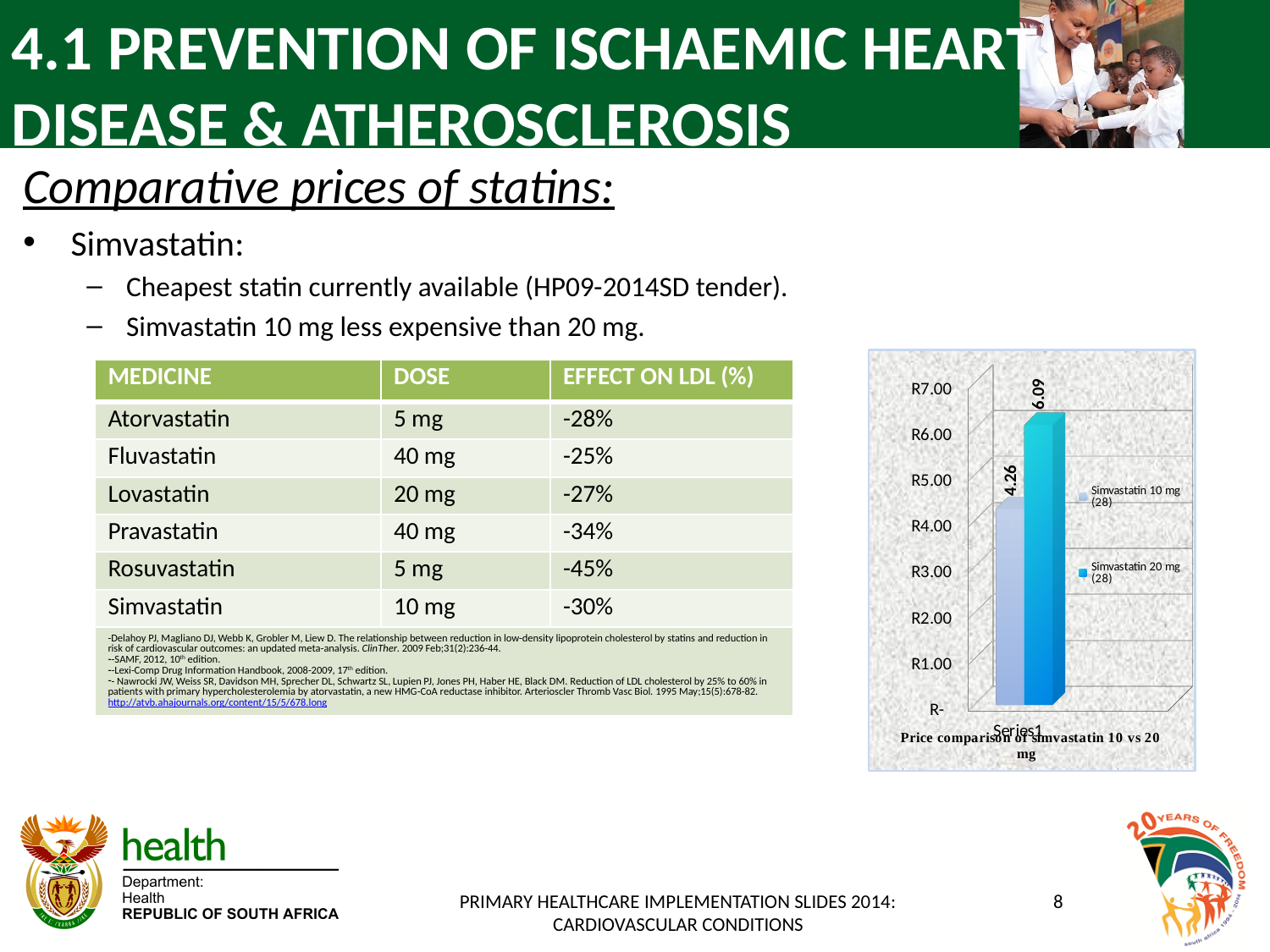
What is the title of the chart on the slide? Price comparison of simvastatin 10 vs 20 mg How many series does the chart legend list? 2 What is the difference between the values for Simvastatin 20 mg (28) and Simvastatin 10 mg (28)? 1.83 Is the value for Simvastatin 20 mg (28) greater or less than R5.00? greater Is the value for Simvastatin 10 mg (28) larger or smaller than the value for Simvastatin 20 mg (28)? smaller What is the value shown for Simvastatin 10 mg (28) in the chart? 4.26 Which series has the lower value in the price comparison chart? Simvastatin 10 mg (28) What is the value shown for Simvastatin 20 mg (28) in the chart? 6.09 Which series has the higher value in the price comparison chart? Simvastatin 20 mg (28) What kind of chart is shown on the slide? Bar chart What is the highest value labelled on the chart's vertical axis? R7.00 Is the value for Simvastatin 10 mg (28) greater or less than R5.00? less